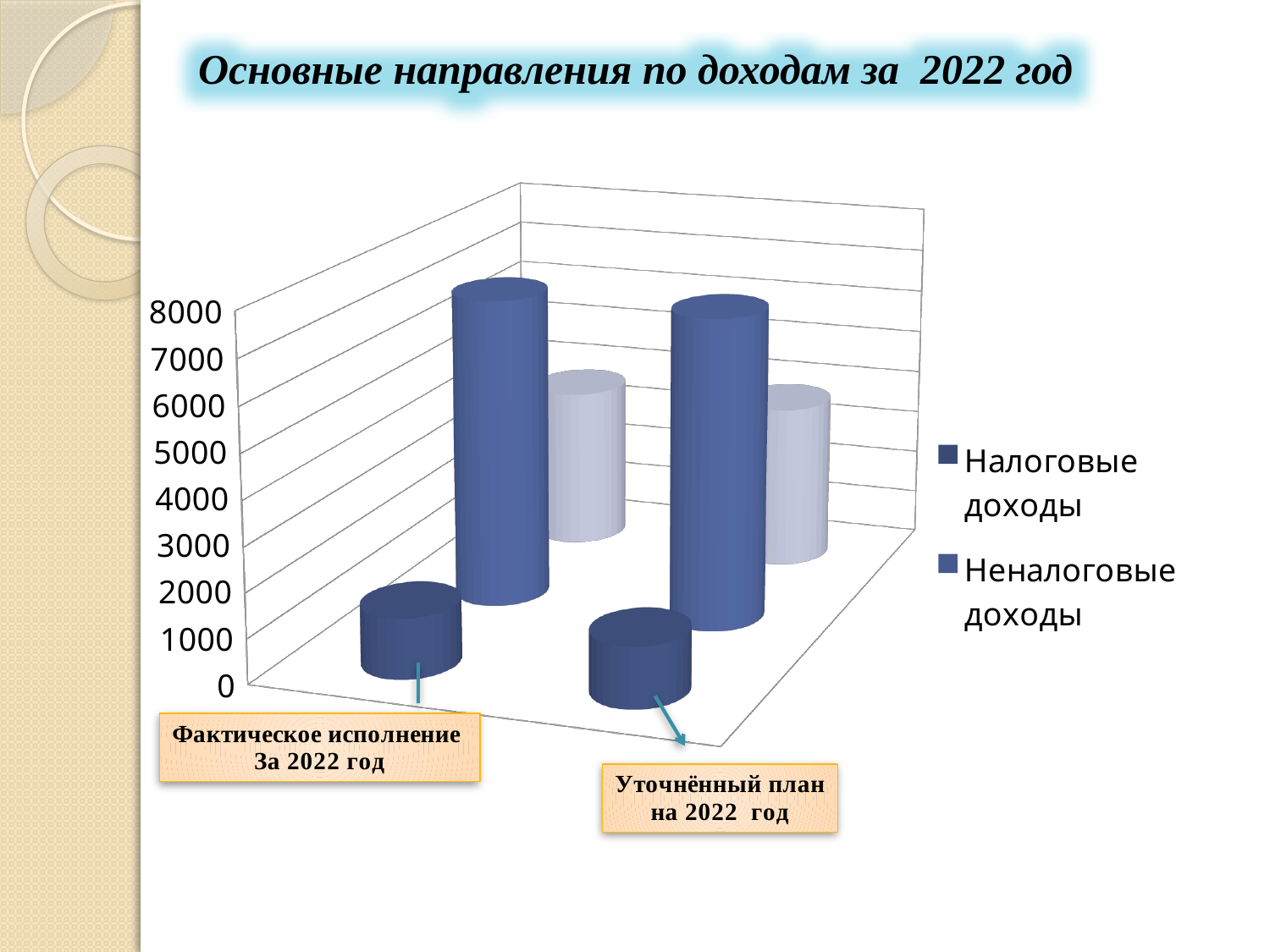
What are the two series named in the legend? Налоговые доходы, Неналоговые доходы Is the value of Налоговые доходы for Фактическое исполнение за 2022 год greater or less than 4000? less For Фактическое исполнение за 2022 год, which is larger: Налоговые доходы or Неналоговые доходы? Неналоговые доходы What is the highest value shown on the vertical axis of the chart? 8000 Is the value of Неналоговые доходы for Уточнённый план на 2022 год greater or less than 1000? greater Is the value of Налоговые доходы for Уточнённый план на 2022 год greater or less than 4000? less How many series does the legend list? 2 What is the title of the chart? Основные направления по доходам за 2022 год What kind of chart is shown on the slide? bar chart How many categories are shown on the x axis of the chart? 2 For Уточнённый план на 2022 год, which is larger: Налоговые доходы or Неналоговые доходы? Неналоговые доходы